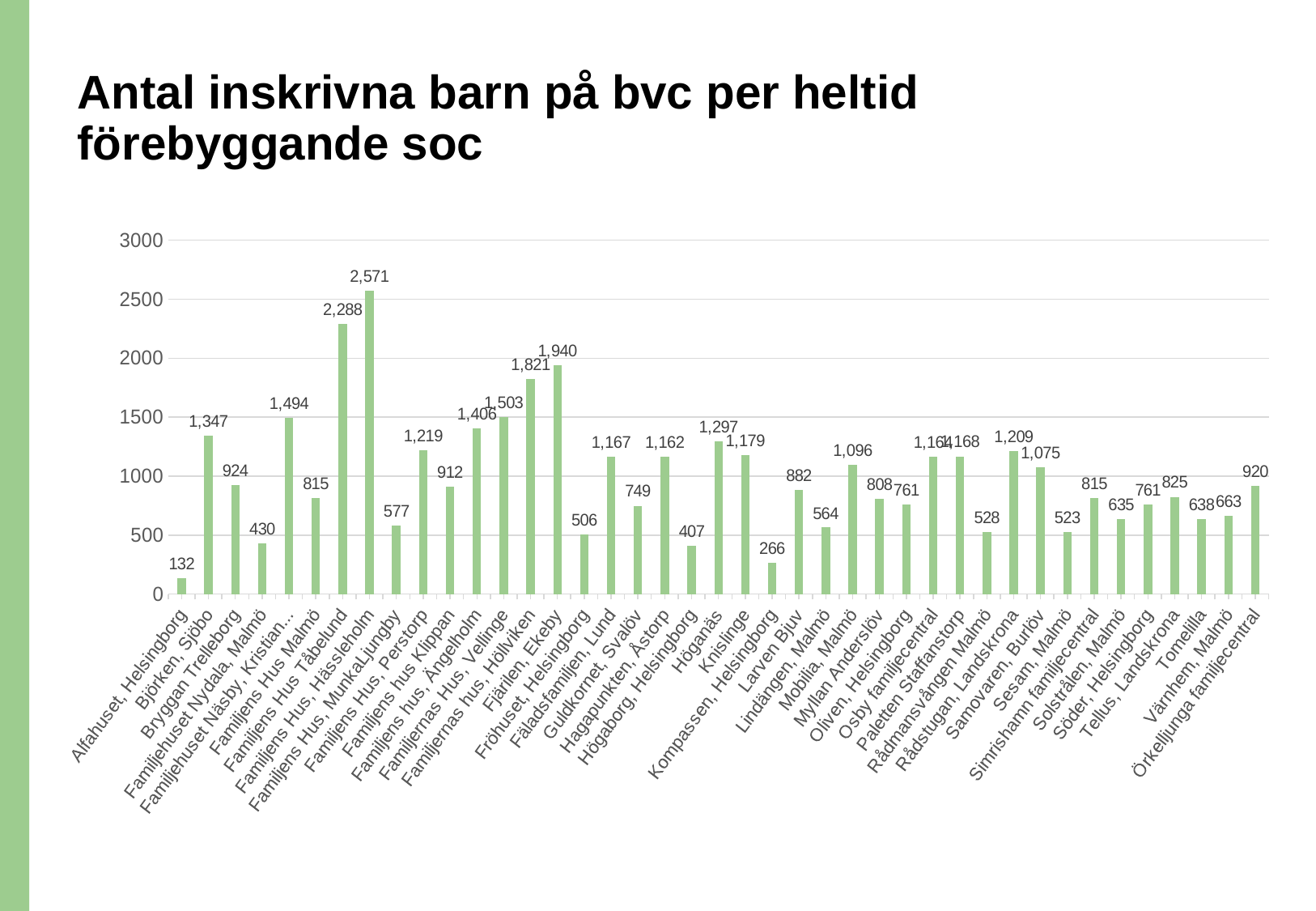
What is the difference between the values for Familjens Hus, Hässleholm and Familjens Hus Tåbelund? 283 What is the value for Rådstugan, Landskrona? 1,209 What kind of chart is shown on the slide? bar chart What is the value for Familjens Hus, Hässleholm? 2,571 What is the difference between the values for Fjärilen, Ekeby and Familjernas hus, Höllviken? 119 Which category has the lowest value? Alfahuset, Helsingborg What is the value for Höganäs? 1,297 Is the value for Larven Bjuv greater or less than 1000? less How many categories are shown on the x axis? 41 What is the value for Kompassen, Helsingborg? 266 Which category has the highest value? Familjens Hus, Hässleholm Which is larger, the value for Björken, Sjöbo or the value for Bryggan Trelleborg? Björken, Sjöbo